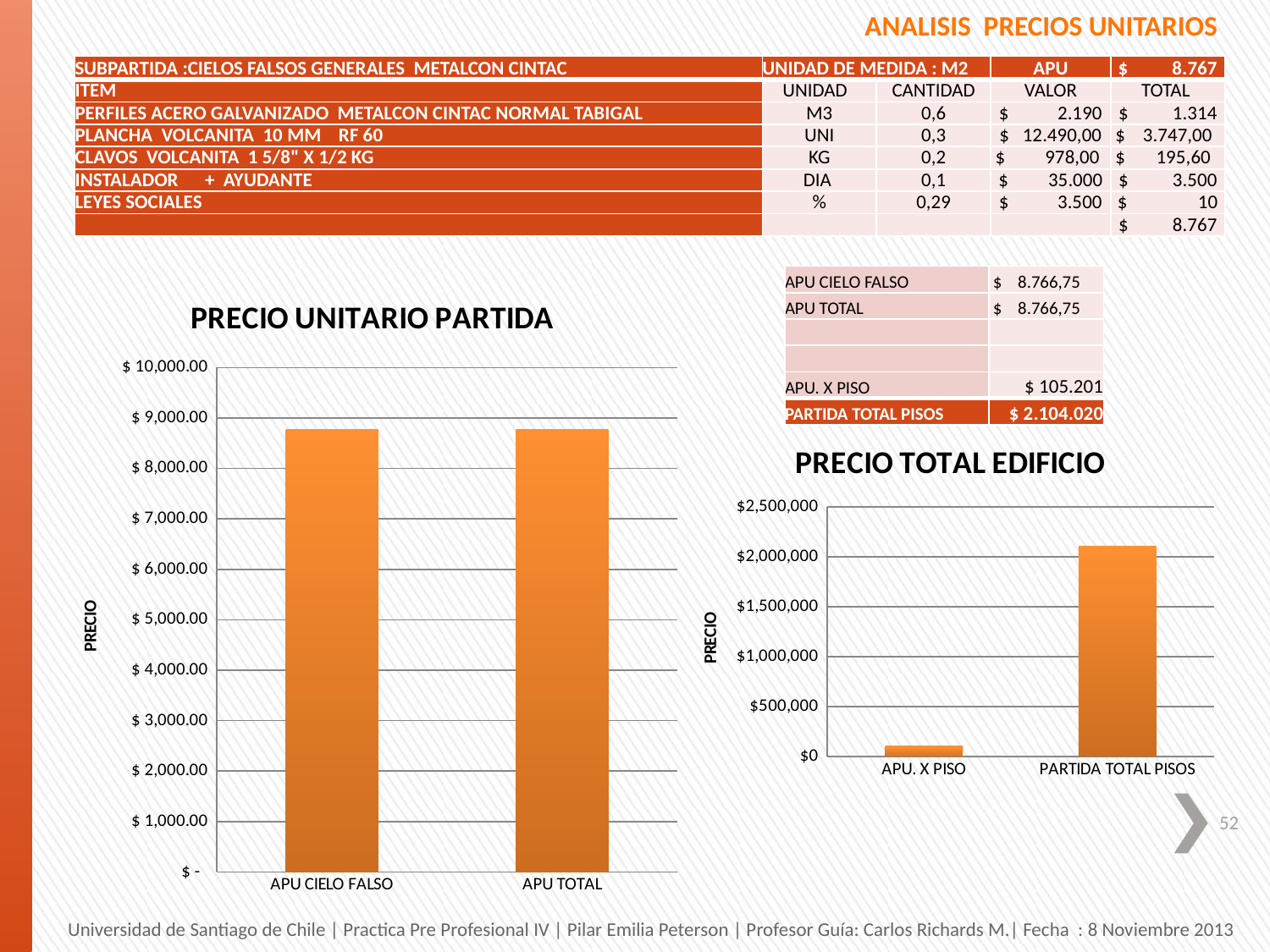
How many bars does the 'PRECIO UNITARIO PARTIDA' chart show? 2 What kind of chart is the 'PRECIO TOTAL EDIFICIO' chart? bar chart In the 'PRECIO UNITARIO PARTIDA' chart, is the value for APU TOTAL greater or less than $ 9,000.00? less In the 'PRECIO TOTAL EDIFICIO' chart, which category has the lowest value? APU. X PISO What is the y-axis title of the 'PRECIO UNITARIO PARTIDA' chart? PRECIO In the 'PRECIO UNITARIO PARTIDA' chart, is the value for APU CIELO FALSO greater or less than $ 8,000.00? greater In the 'PRECIO TOTAL EDIFICIO' chart, which category has the highest value? PARTIDA TOTAL PISOS In the 'PRECIO TOTAL EDIFICIO' chart, is the value for PARTIDA TOTAL PISOS greater or less than $2,000,000? greater What kind of chart is the 'PRECIO UNITARIO PARTIDA' chart? bar chart How many categories does the 'PRECIO TOTAL EDIFICIO' chart show? 2 In the 'PRECIO TOTAL EDIFICIO' chart, which is larger, APU. X PISO or PARTIDA TOTAL PISOS? PARTIDA TOTAL PISOS